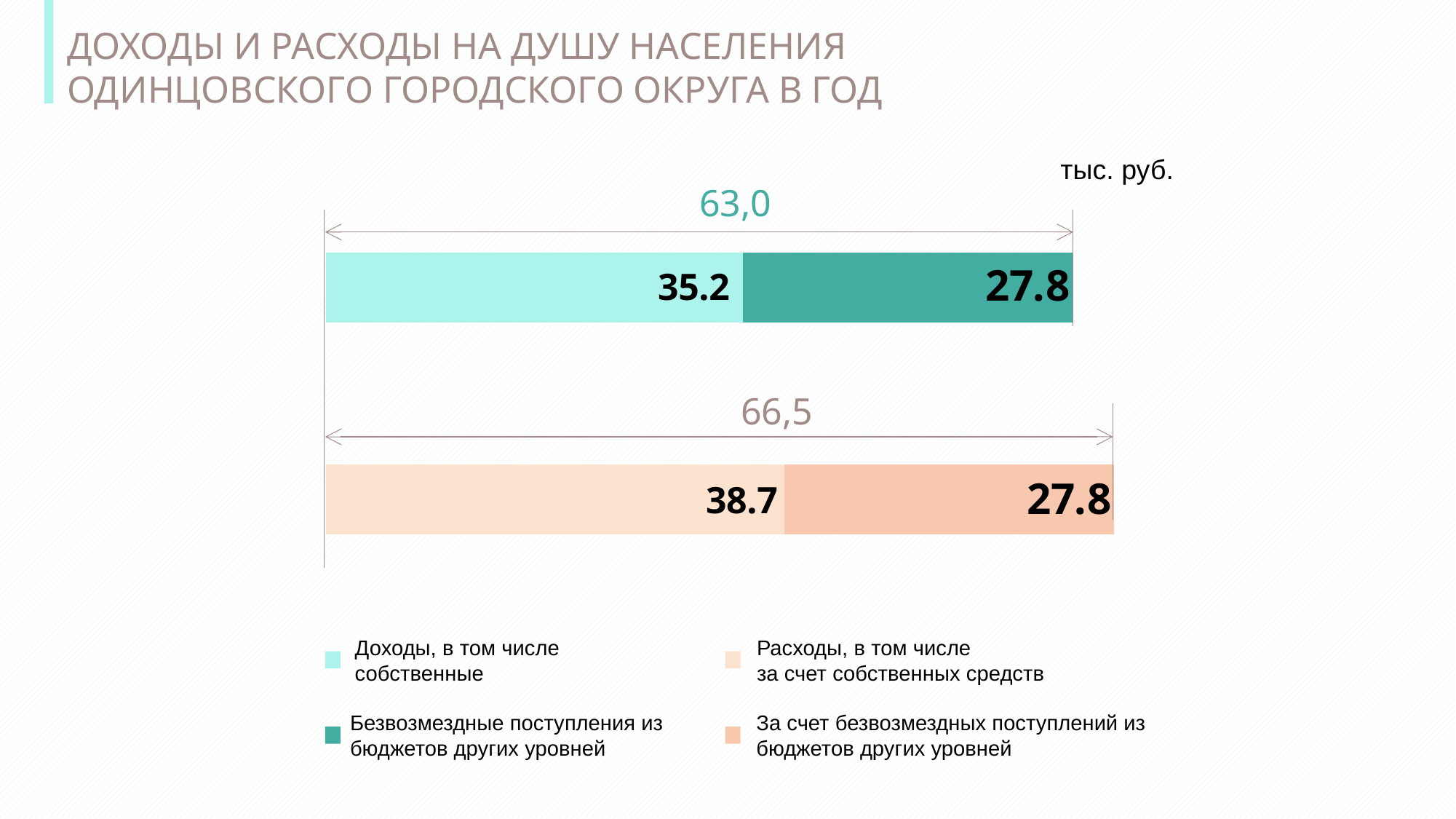
What is the value of expenses from own funds (Расходы за счет собственных средств) per capita? 38.7 What is the total shown for the income (Доходы) bar? 63,0 Which bar has the larger total: income (Доходы) or expenses (Расходы)? Расходы How many bars are shown in the chart? 2 What unit of measurement is indicated for the chart values? тыс. руб. What is the value of gratuitous receipts from budgets of other levels in the income bar? 27.8 What is the value of own income (Доходы, в том числе собственные) per capita? 35.2 Which segment is larger in the expenses bar: own funds or gratuitous receipts from other budgets? own funds (38.7) What is the difference between the expenses total (66,5) and the income total (63,0)? 3,5 What is the difference between expenses from own funds (38.7) and own income (35.2)? 3.5 How many entries does the legend list? 4 What is the total shown for the expenses (Расходы) bar? 66,5